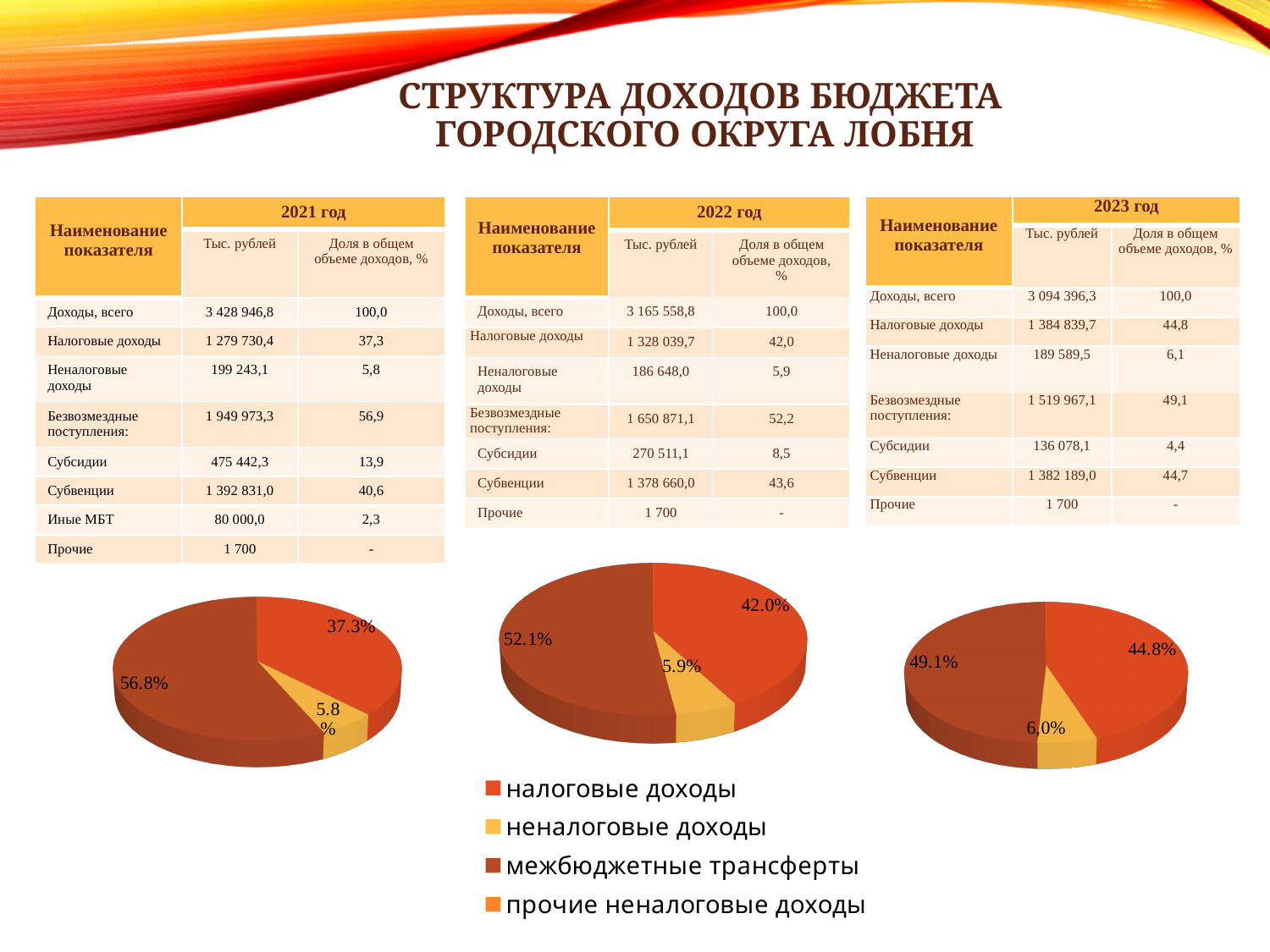
In the middle pie chart, what is the difference between the shares of межбюджетные трансферты and налоговые доходы? 10.1 percentage points In the middle pie chart, what share is shown for межбюджетные трансферты? 52.1% In the right pie chart, what share is shown for неналоговые доходы? 6,0% What kind of chart is the left chart on the slide? pie chart In the left pie chart, which category has the largest slice? межбюджетные трансферты In the left pie chart, what share is shown for налоговые доходы? 37.3% How many pie charts are shown on the slide? 3 How many entries does the legend below the pie charts list? 4 In the middle pie chart, what share is shown for налоговые доходы? 42.0% In the left pie chart, what is the difference between the shares of межбюджетные трансферты and налоговые доходы? 19.5 percentage points In the right pie chart, which is larger: налоговые доходы or межбюджетные трансферты? межбюджетные трансферты